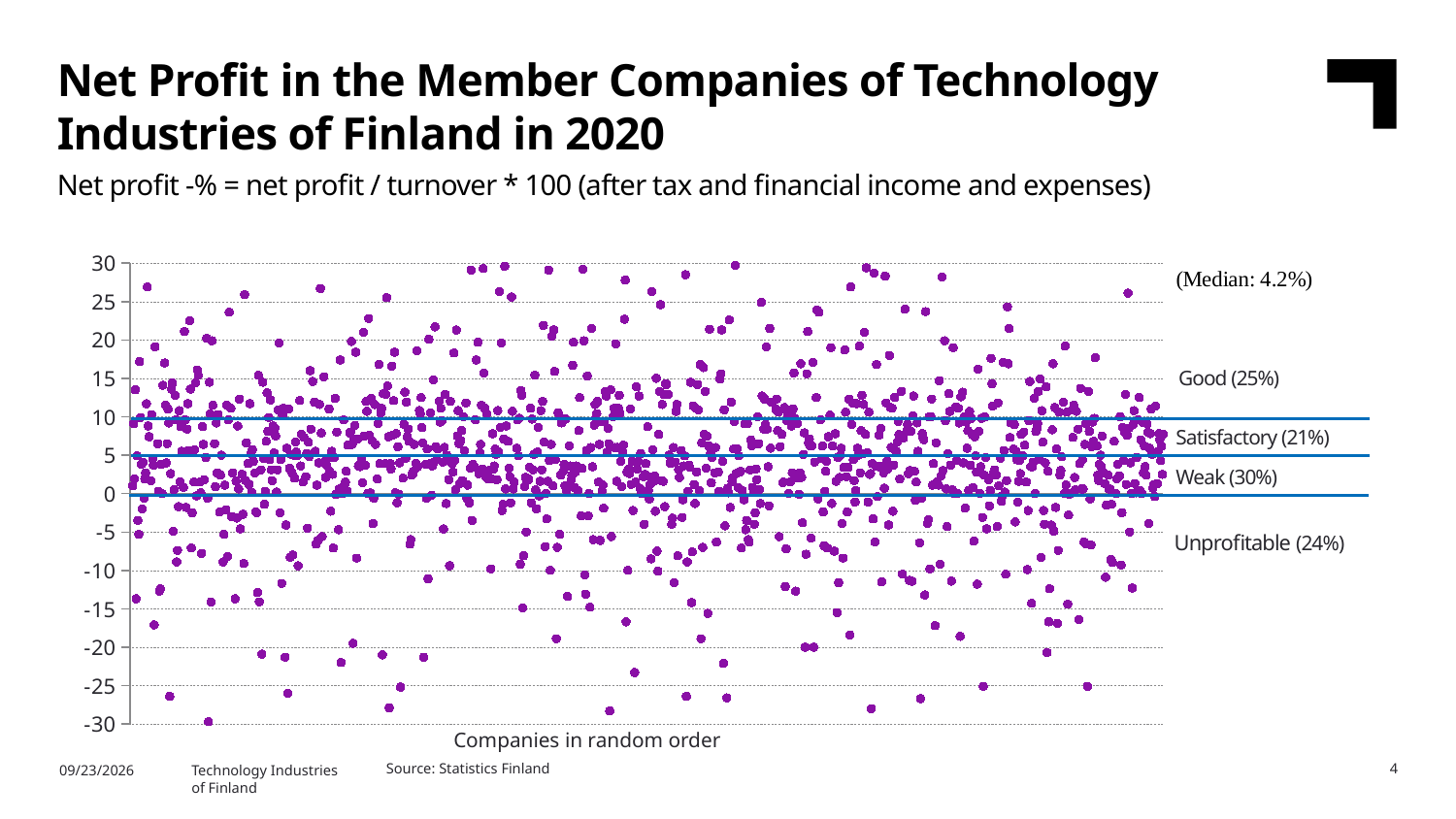
What share of companies falls into the Satisfactory category? 21% What is the difference in percentage points between the Weak share and the Satisfactory share? 9 Which profitability category contains the largest share of companies? Weak Which category has a larger share of companies, Good or Unprofitable? Good What kind of chart is shown on the slide? Scatter chart What share of companies falls into the Good category? 25% How many profitability categories are labelled on the chart? 4 What is the label of the x axis? Companies in random order What share of companies falls into the Unprofitable category? 24% Which profitability category contains the smallest share of companies? Satisfactory What is the median net profit percentage shown on the chart? 4.2% What share of companies falls into the Weak category? 30%